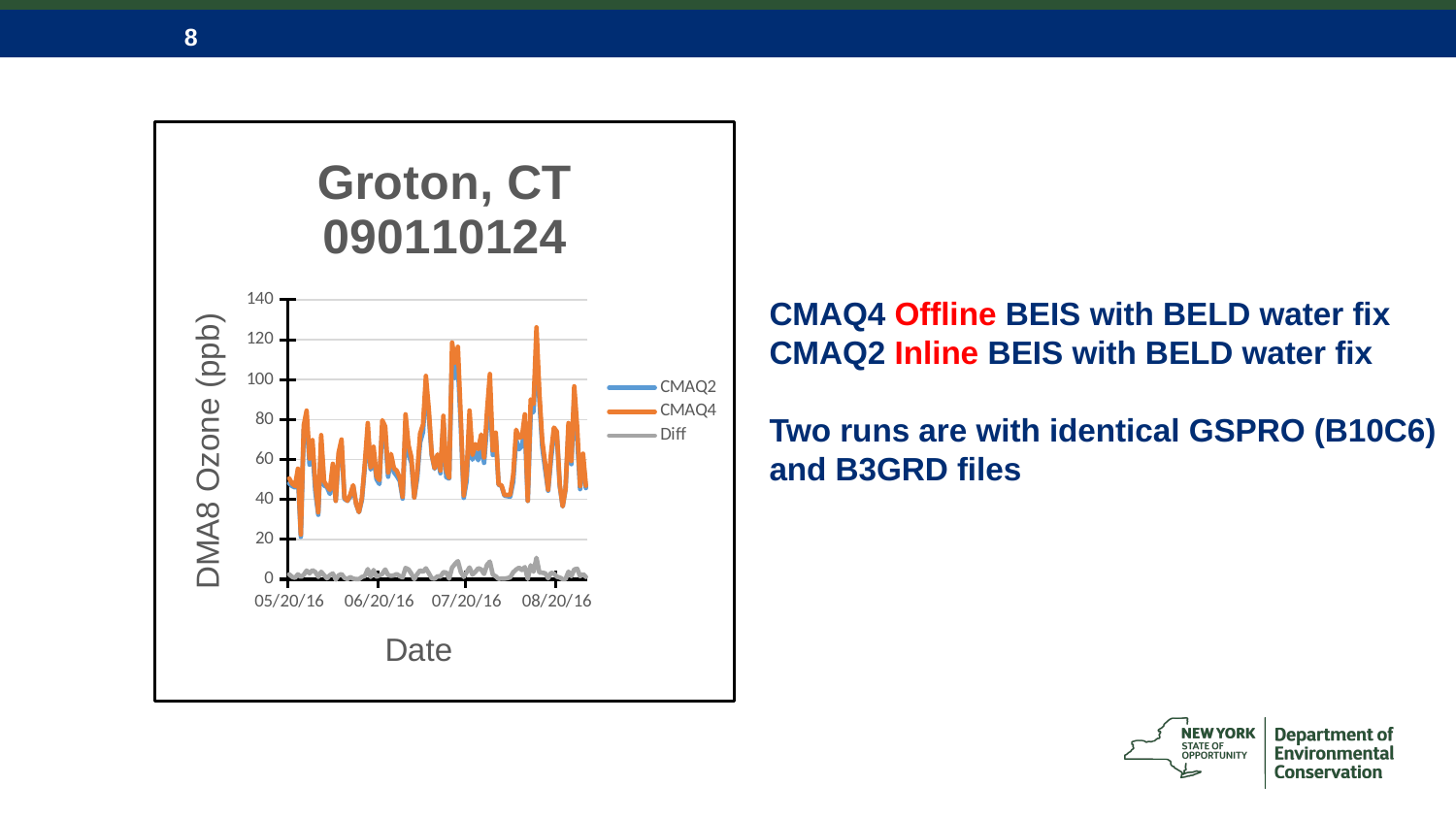
Is the highest value of the CMAQ4 series greater or less than 100? greater What kind of chart is shown on the slide? line chart What is the title of the chart? Groton, CT 090110124 Is the lowest value of the CMAQ4 series greater or less than 40? less What is the label on the chart's y axis? DMA8 Ozone (ppb) Which series stays closest to zero across the whole chart? Diff Which series has lower values throughout the chart, Diff or CMAQ4? Diff How many series does the chart's legend list? 3 How many date labels are shown on the x axis? 4 Is the highest value of the Diff series greater or less than 20? less